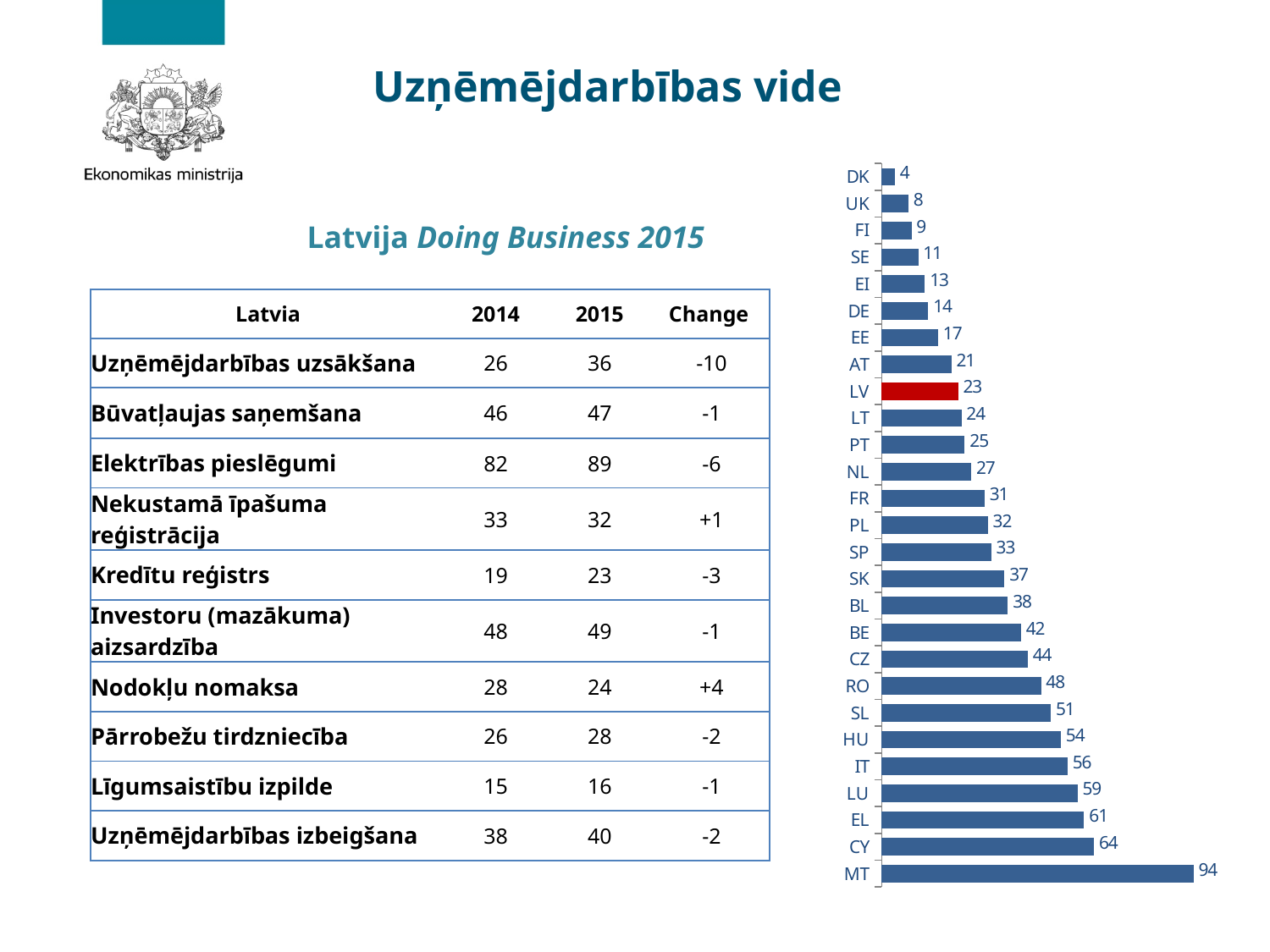
Which has a larger value in the bar chart, EE or AT? AT What is the value for DK in the bar chart? 4 How many countries are shown in the bar chart? 27 What kind of chart is shown on the slide? bar chart What is the value for MT in the bar chart? 94 Which bar in the chart is coloured red rather than blue? LV Which country has the lowest value in the bar chart? DK What is the value for LV in the bar chart? 23 What is the difference between the values for LT and LV in the bar chart? 1 What is the difference between the values for MT and CY in the bar chart? 30 Which country has the highest value in the bar chart? MT What is the value for FR in the bar chart? 31